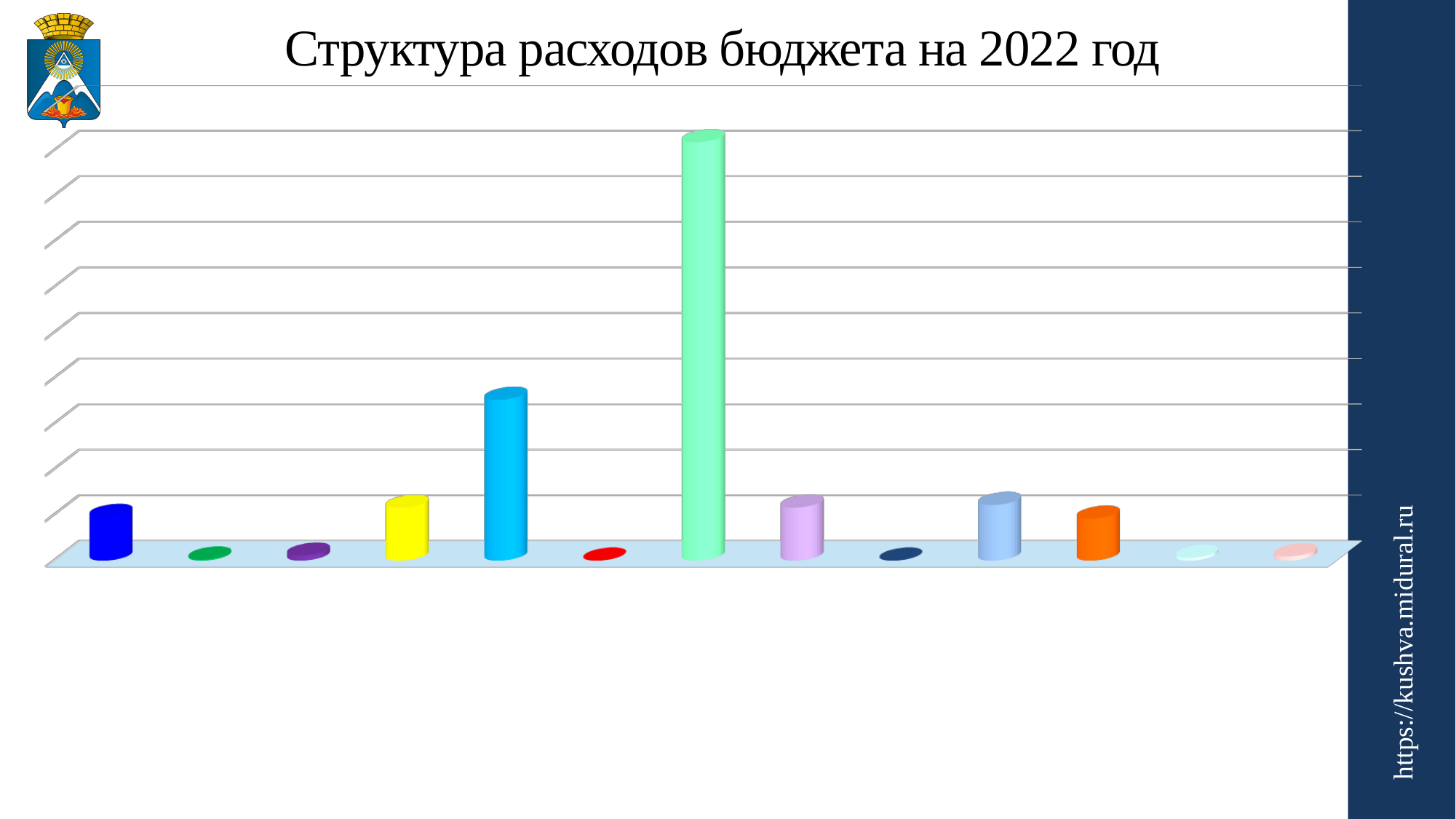
Which is taller, the light green bar (seventh from the left) or the cyan bar (fifth from the left)? the light green bar Which is taller, the dark blue bar (first from the left) or the red bar (sixth from the left)? the dark blue bar What is the title of the chart on the slide? Структура расходов бюджета на 2022 год Which is taller, the orange bar (eleventh from the left) or the cyan bar (fifth from the left)? the cyan bar Does the chart display a legend? No Which bar is the tallest in the chart? the light green bar (seventh from the left) How many bars are plotted in the chart? 13 What kind of chart is shown on the slide? bar chart